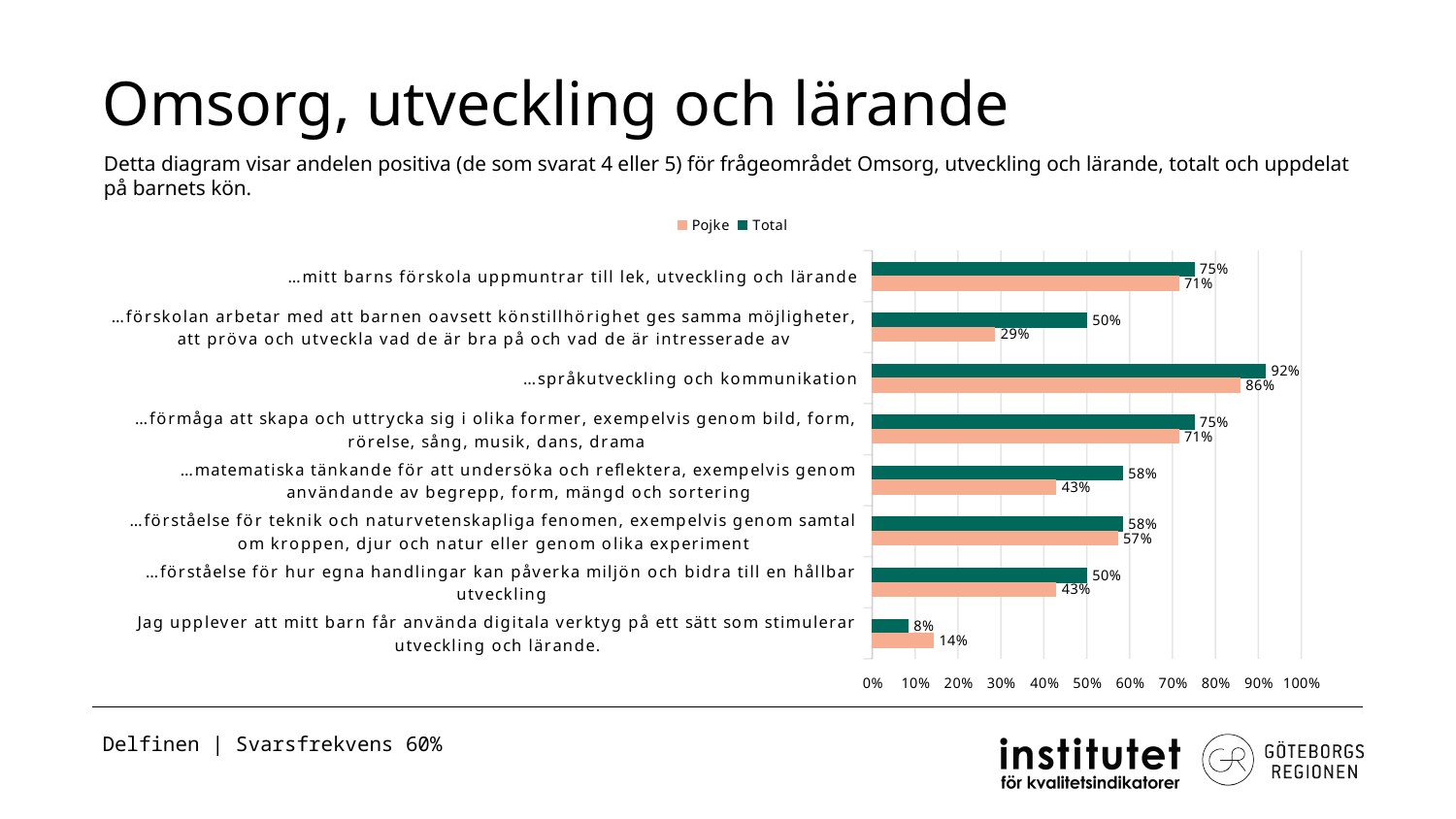
What is the Pojke value for "Jag upplever att mitt barn får använda digitala verktyg på ett sätt som stimulerar utveckling och lärande."? 14% What kind of chart is shown on the slide? Bar chart What are the two series named in the legend? Pojke and Total Is the Pojke value for "…språkutveckling och kommunikation" greater or less than 80%? greater How many categories are shown in the chart? 8 For "Jag upplever att mitt barn får använda digitala verktyg på ett sätt som stimulerar utveckling och lärande.", which is larger, the Pojke value or the Total value? Pojke Which category has the lowest Pojke value? Jag upplever att mitt barn får använda digitala verktyg på ett sätt som stimulerar utveckling och lärande. What is the Pojke value for "…förskolan arbetar med att barnen oavsett könstillhörighet ges samma möjligheter, att pröva och utveckla vad de är bra på och vad de är intresserade av"? 29% How many series does the legend list? 2 What is the Total value for "…språkutveckling och kommunikation"? 92% Which category has the highest Total value? …språkutveckling och kommunikation What is the difference between the Total and Pojke values for "…matematiska tänkande för att undersöka och reflektera, exempelvis genom användande av begrepp, form, mängd och sortering"? 15 percentage points